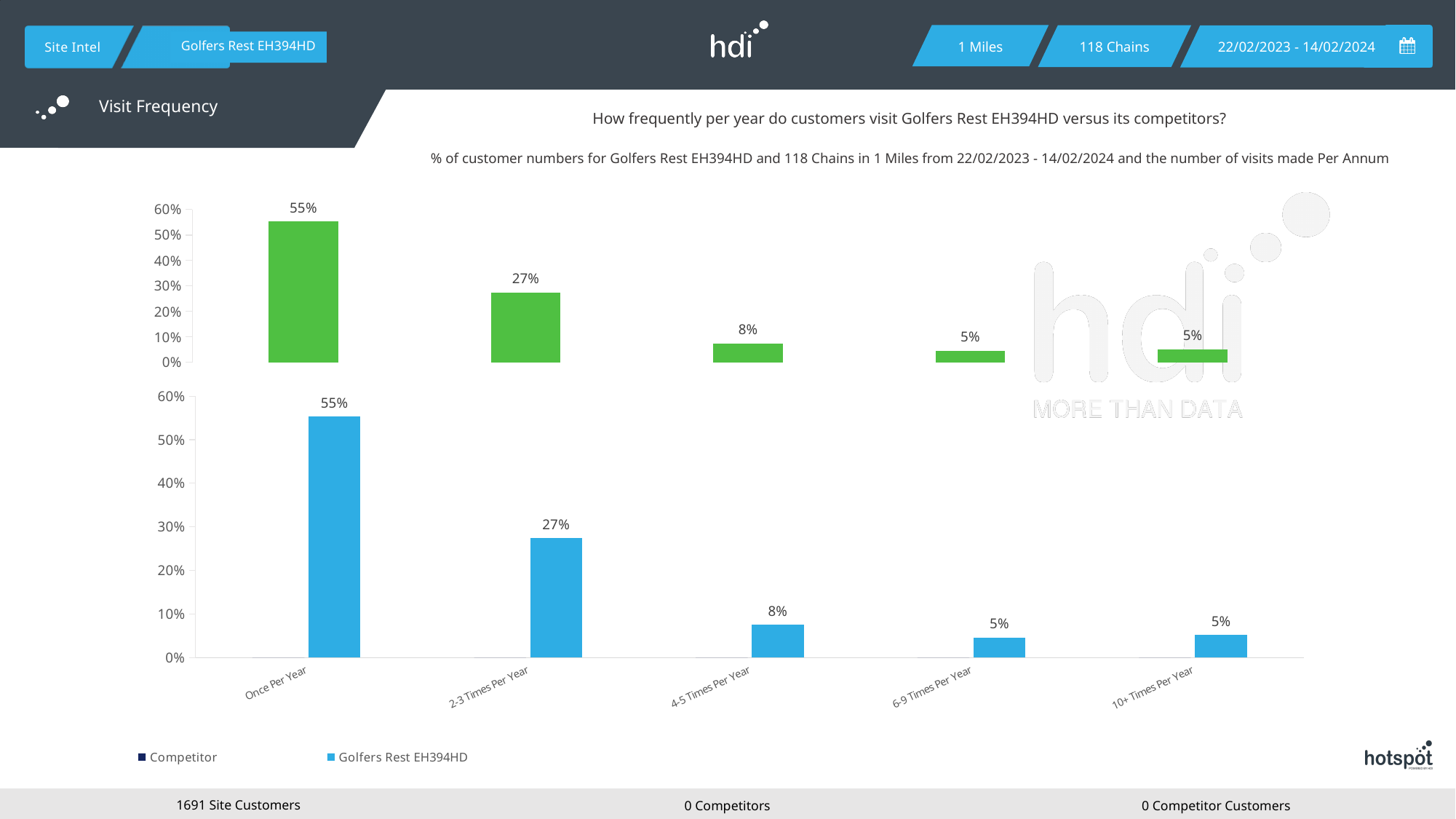
How many categories are shown on the x axis of the bottom chart? 5 In the bottom chart, what is the value for 6-9 Times Per Year? 5% In the top chart, what is the value shown on the first (leftmost) bar? 55% In the bottom chart, do the values generally rise or fall from left to right along the x axis? Fall In the bottom chart, which is larger: the value for 2-3 Times Per Year or the value for 4-5 Times Per Year? 2-3 Times Per Year In the bottom chart, what is the value for Once Per Year? 55% How many entries does the legend at the bottom of the slide list? 2 In the bottom chart, what is the value for 2-3 Times Per Year? 27% What kind of chart is the bottom chart? Bar chart In the bottom chart, what is the difference between the values for Once Per Year and 2-3 Times Per Year? 28% In the bottom chart, which category has the highest value? Once Per Year In the bottom chart, what is the value for 4-5 Times Per Year? 8%